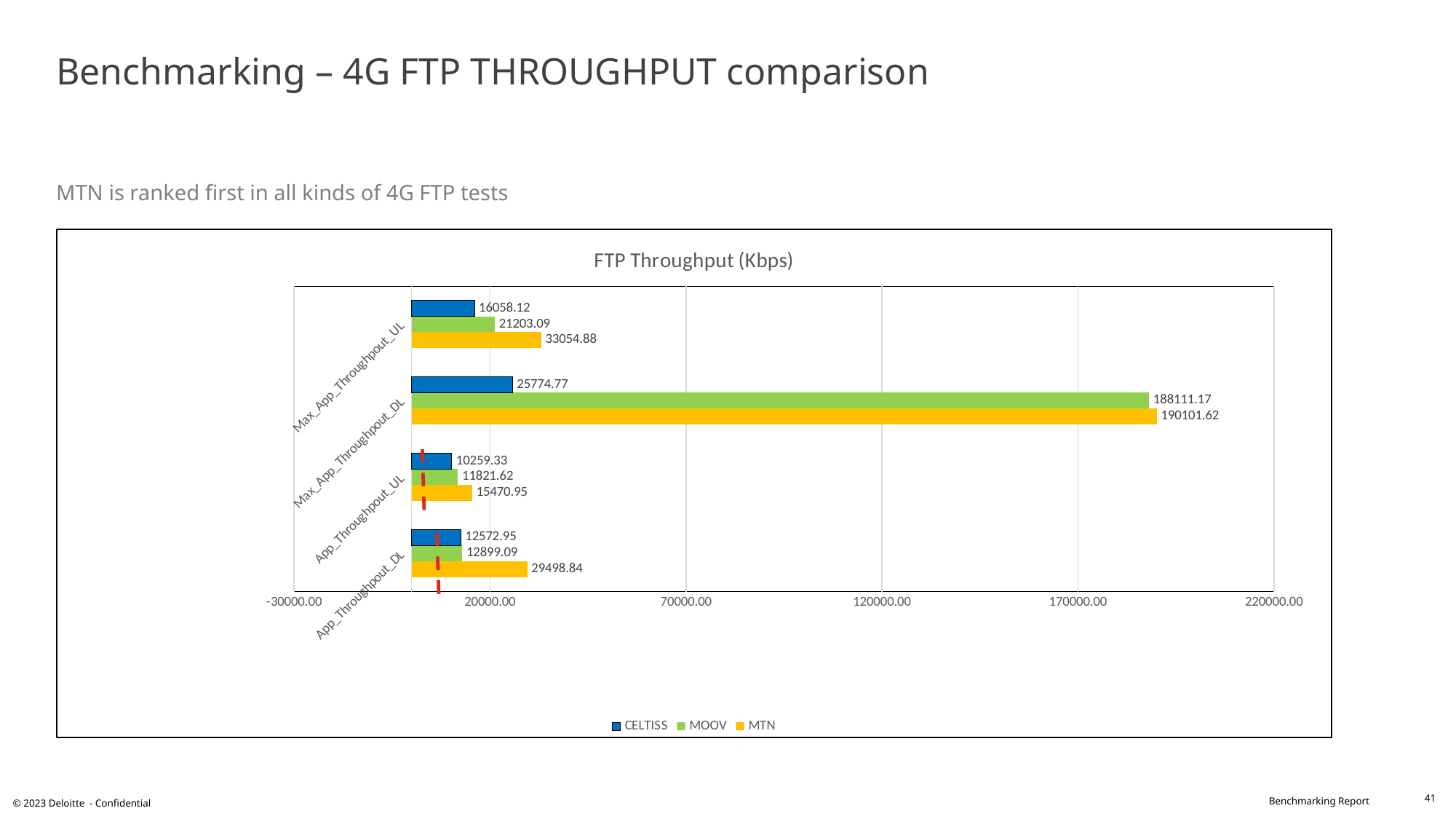
Which category has the lowest CELTISS value? App_Throughpout_UL What is the MTN value for App_Throughpout_DL? 29498.84 Which category has the highest MTN value? Max_App_Throughpout_DL What is the CELTISS value for Max_App_Throughpout_UL? 16058.12 What is the difference between the MTN and MOOV values for Max_App_Throughpout_DL? 1990.45 What is the difference between the MTN and CELTISS values for Max_App_Throughpout_UL? 16996.76 What is the MTN value for Max_App_Throughpout_DL? 190101.62 For App_Throughpout_DL, which is larger: the MTN value or the MOOV value? MTN What type of chart is shown on the slide? bar chart What is the MOOV value for App_Throughpout_UL? 11821.62 How many series does the legend list? 3 What is the title of the chart? FTP Throughput (Kbps)